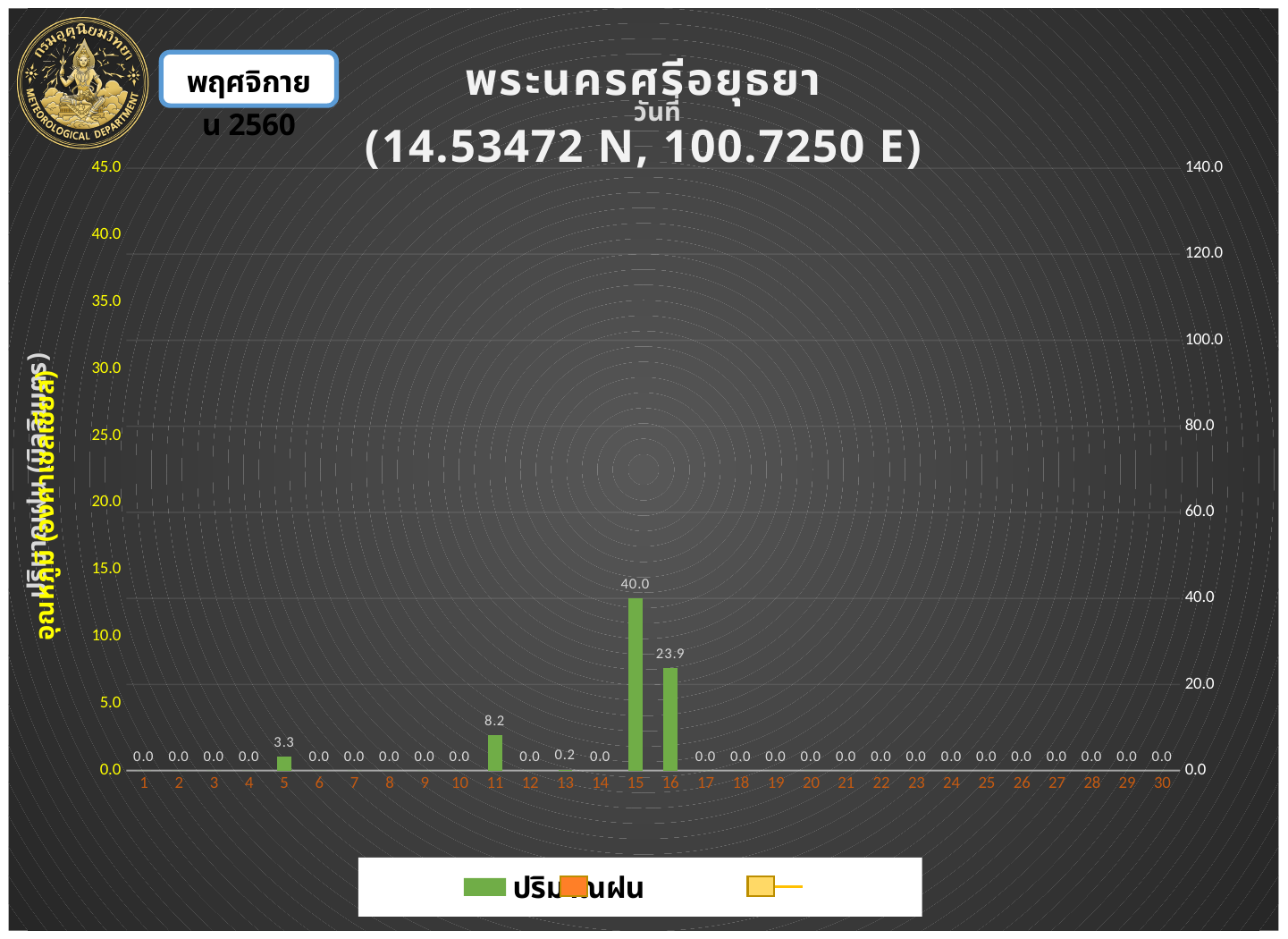
What kind of chart is used to show the rainfall values? bar chart What is the total rainfall for days 5 and 11 combined? 11.5 What is the rainfall value shown for day 11? 8.2 What colour are the rainfall (ปริมาณฝน) bars? green Which has the larger rainfall value, day 11 or day 16? day 16 What is the rainfall value shown for day 15? 40.0 What is the rainfall value shown for day 16? 23.9 How many days are shown on the x axis? 30 What is the rainfall value shown for day 13? 0.2 What is the difference between the rainfall values for day 15 and day 16? 16.1 Which day has the highest rainfall value? 15 What is the rainfall value shown for day 5? 3.3